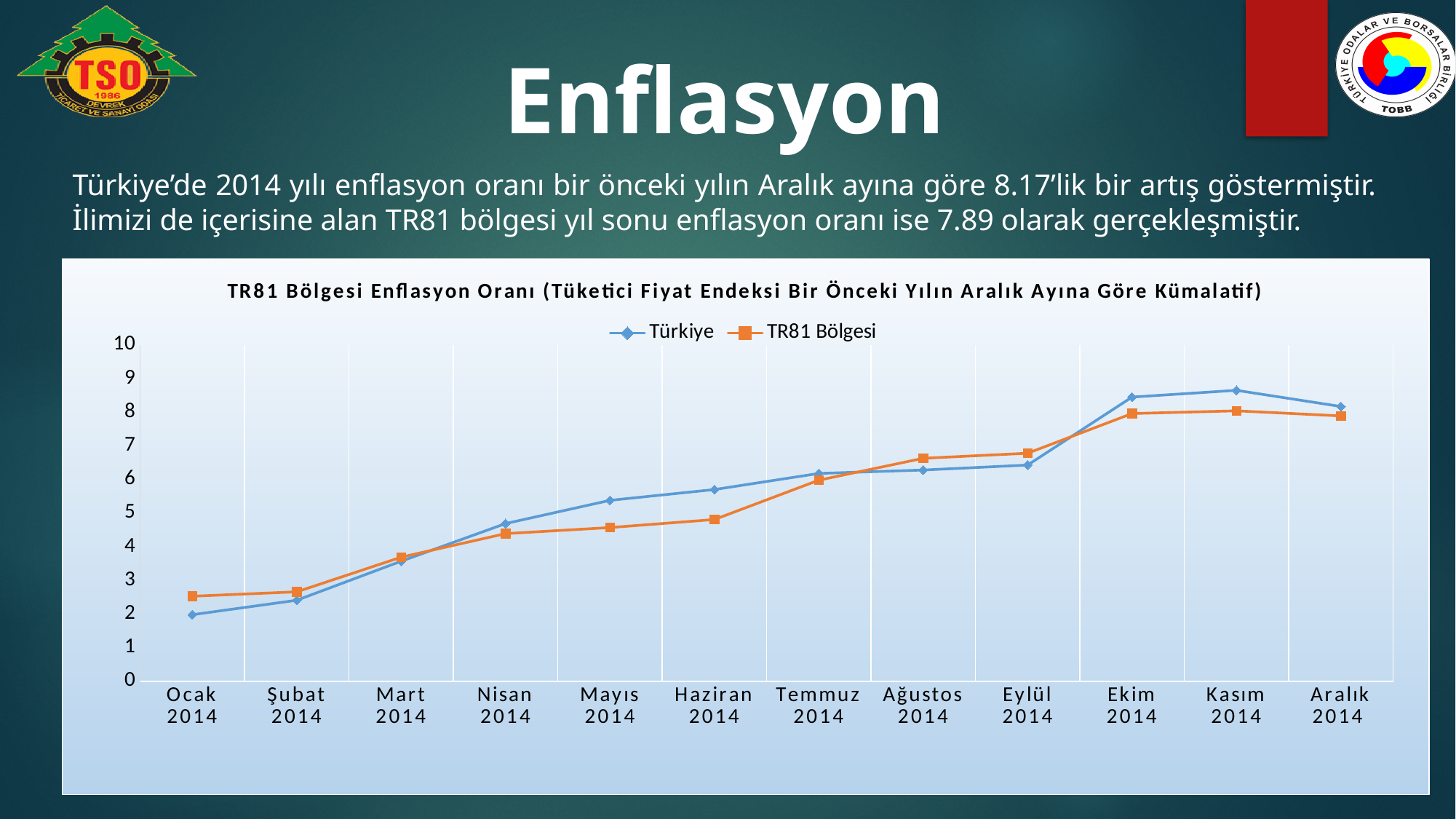
What are the two entries in the chart legend? Türkiye and TR81 Bölgesi In Mayıs 2014, which series has the larger value, Türkiye or TR81 Bölgesi? Türkiye Is the value for TR81 Bölgesi in Mayıs 2014 greater or less than 5? less In Ağustos 2014, which series has the larger value, Türkiye or TR81 Bölgesi? TR81 Bölgesi How many series does the chart legend list? 2 What kind of chart is shown on the slide? line chart Is the value for Türkiye in Ocak 2014 greater or less than 3? less Is the value for Türkiye in Ekim 2014 greater or less than 8? greater How many months are plotted along the x axis of the chart? 12 Does the Türkiye series generally rise or fall from Ocak 2014 to Kasım 2014? rise In which month is the Türkiye series at its lowest value? Ocak 2014 In which month does the Türkiye series reach its highest value? Kasım 2014